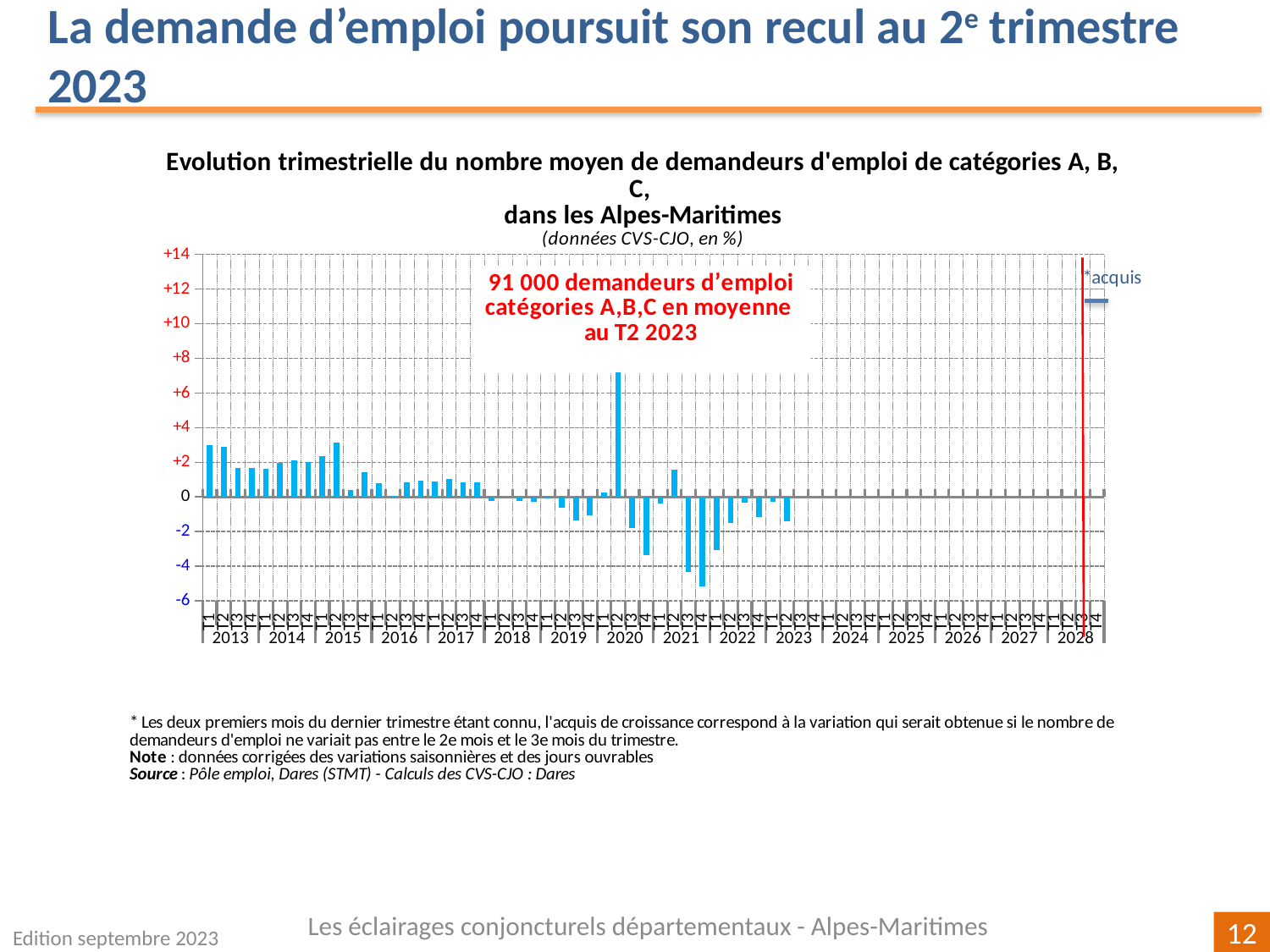
Is the value for T2 2020 greater or less than +6? greater Do the values rise or fall across the four quarters of 2013? fall What kind of chart is shown on the slide? bar chart Which is larger, the value for T1 2013 or the value for T2 2020? T2 2020 Is the value for T1 2013 greater or less than +2? greater What is the average number of category A, B, C job seekers in T2 2023 stated in the red annotation on the chart? 91 000 Which quarter has the lowest value in the chart? T4 2021 Is the value for T1 2021 greater or less than -2? greater Which quarter has the highest value in the chart? T2 2020 Which is larger, the value for T1 2021 or the value for T2 2021? T2 2021